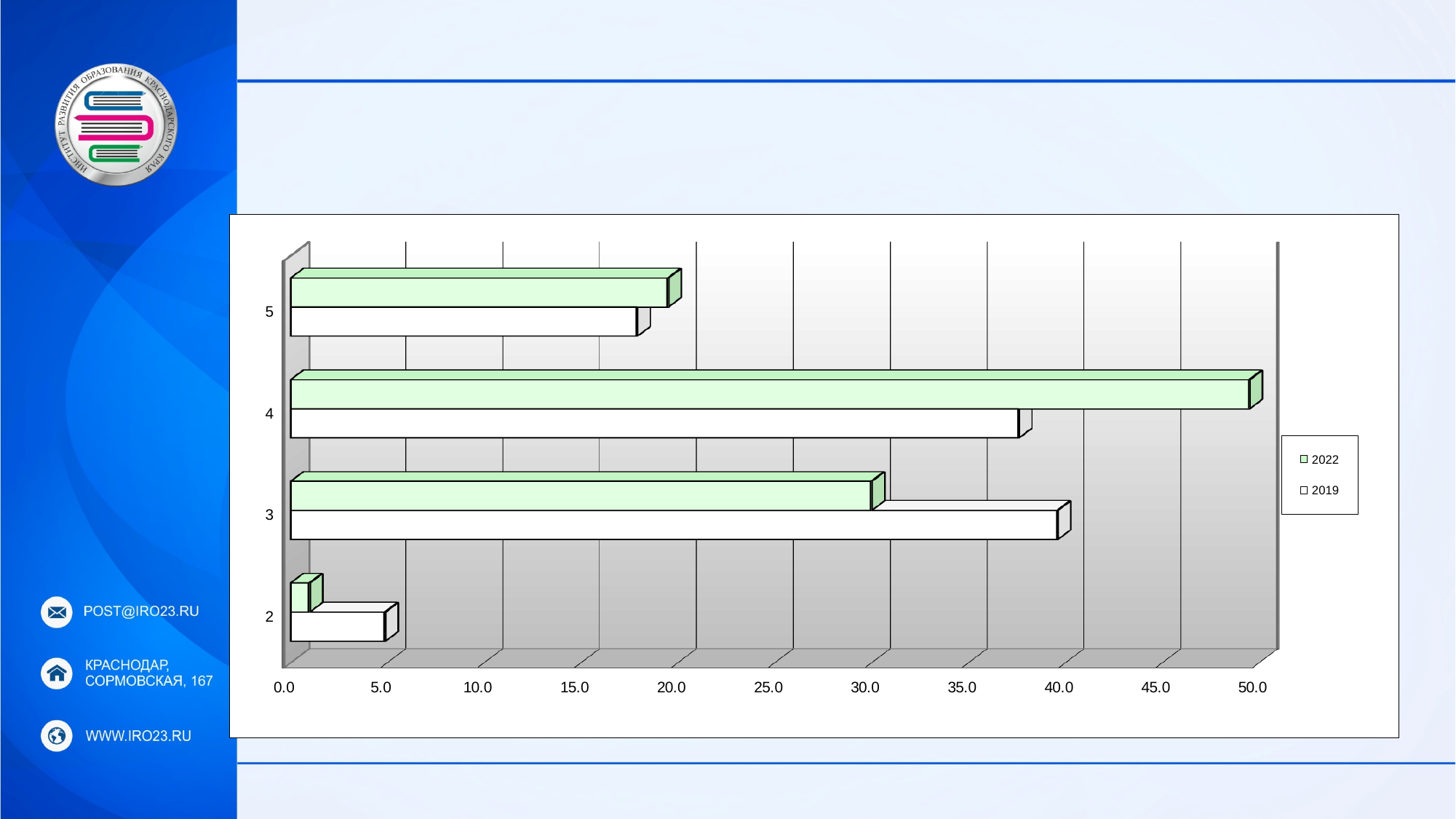
For category 3, which series has the larger value, 2022 or 2019? 2019 Which category has the lowest value for the 2022 series? 2 Which series is shown in green in the legend? 2022 Which category has the highest value for the 2022 series? 4 How many categories are plotted on the vertical axis? 4 How many series does the legend list? 2 Is the 2022 value for category 4 greater or less than 45.0? greater Which category has the lowest value for the 2019 series? 2 Which category has the highest value for the 2019 series? 3 For category 4, which series has the larger value, 2022 or 2019? 2022 Is the 2022 value for category 2 greater or less than 5.0? less What kind of chart is shown on the slide? bar chart